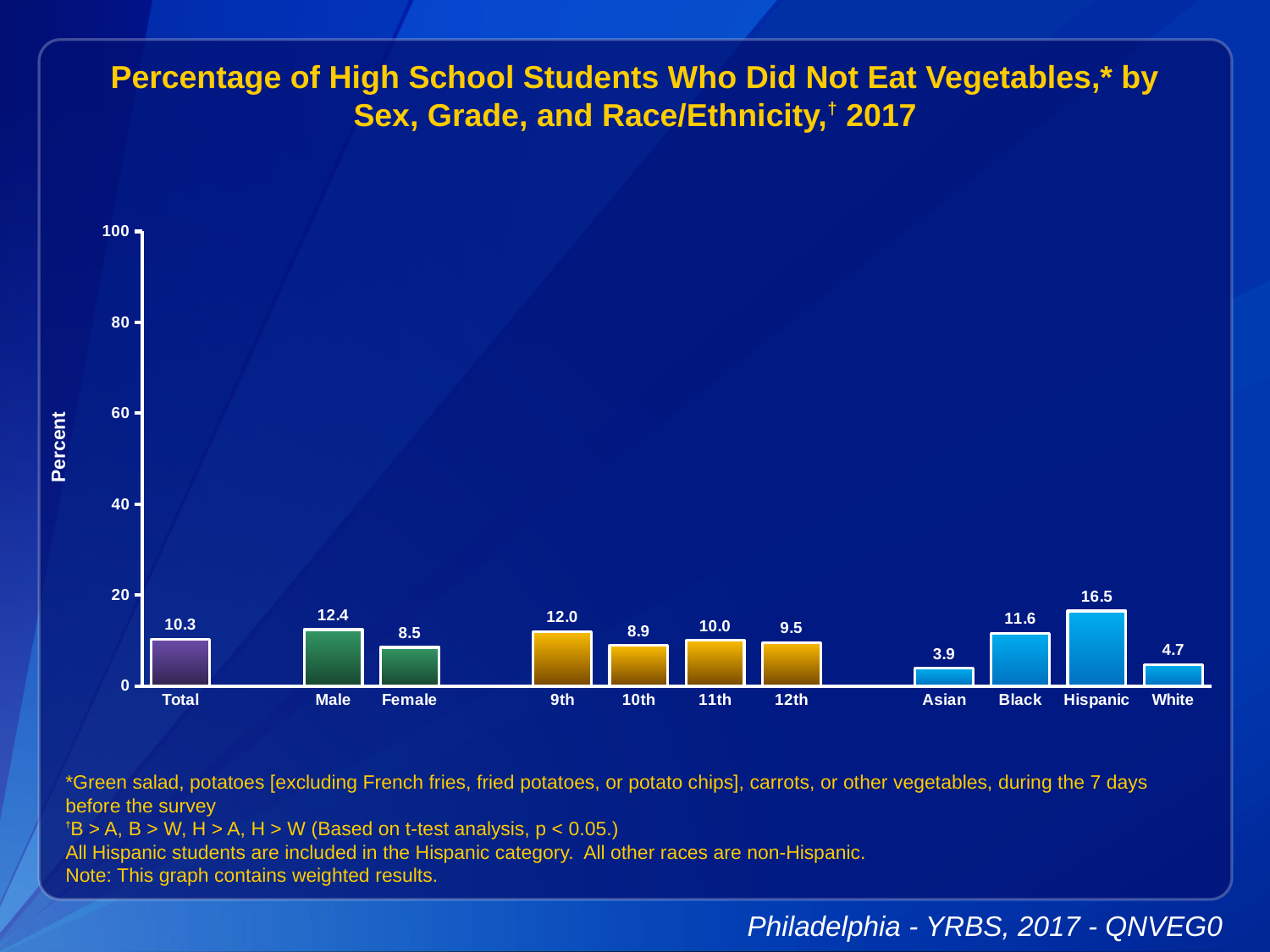
What is the value for Hispanic students? 16.5 Which category has the lowest value? Asian What kind of chart is this? bar chart Which is larger, the value for Black or the value for White? Black Do the values rise or fall from 9th grade to 10th grade? fall What is the difference between the values for Male and Female? 3.9 What is the value for 10th grade students? 8.9 Is the value for 9th grade greater or less than 20? less What is the label on the y axis? Percent Which category has the highest value? Hispanic How many categories are shown on the x axis? 11 What is the value for Total? 10.3